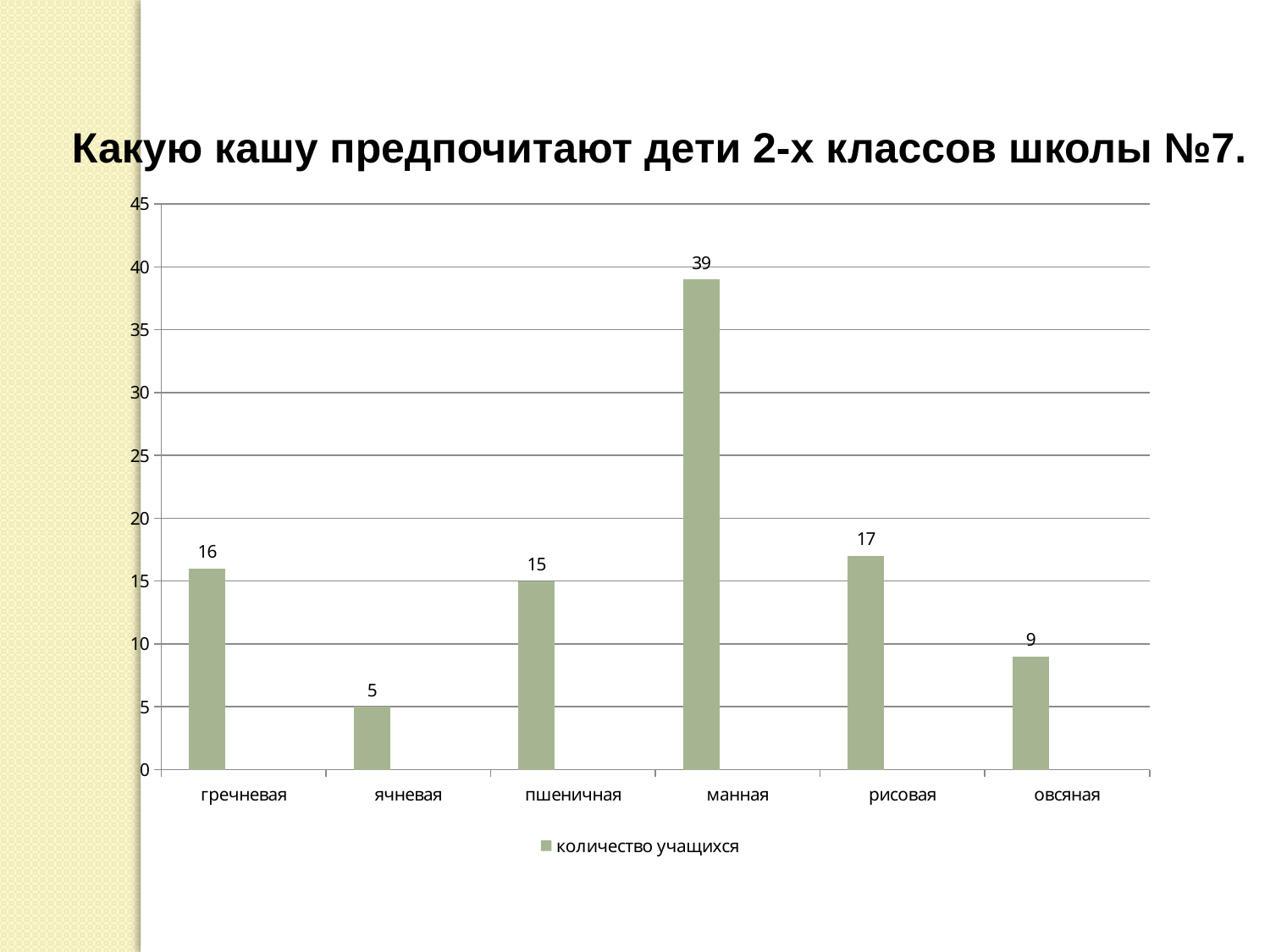
How many categories are shown on the x axis? 6 Which is larger, the value for рисовая or the value for овсяная? рисовая Which category has the highest value? манная Which category has the lowest value? ячневая Is the value for манная greater or less than 35? greater What is the value for ячневая? 5 What kind of chart is shown on the slide? bar chart What series name does the legend show? количество учащихся What is the difference between the values for манная and рисовая? 22 What is the value for манная? 39 What is the difference between the values for гречневая and пшеничная? 1 What is the value for овсяная? 9